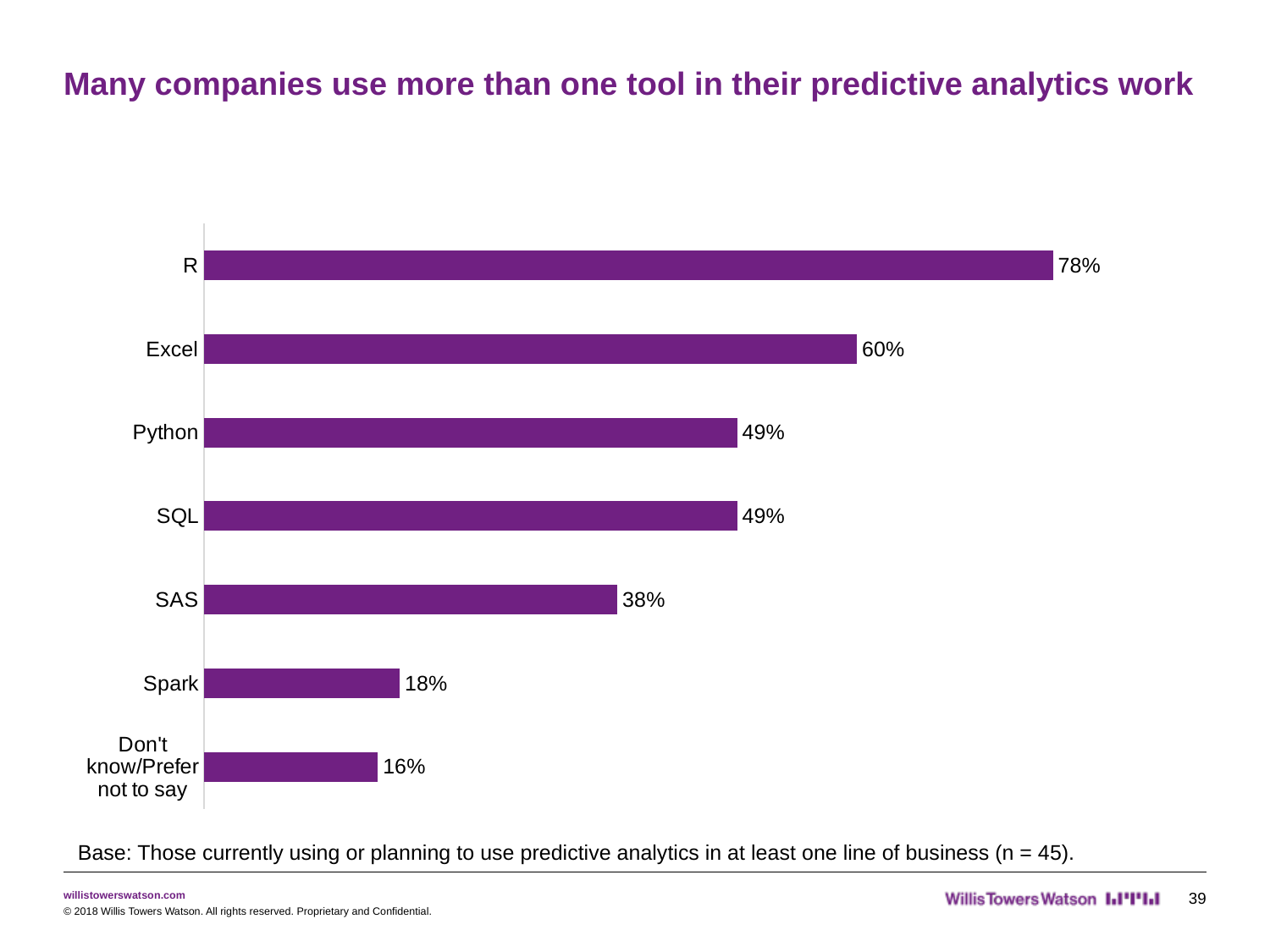
Which is larger, the value for SAS or the value for Spark? SAS What percentage is shown for SAS? 38% What percentage of companies use R? 78% What is the value shown for Excel? 60% What is the title of the slide? Many companies use more than one tool in their predictive analytics work How many categories are shown in the chart? 7 What is the value for Spark? 18% What kind of chart is shown on the slide? Bar chart What is the value for 'Don't know/Prefer not to say'? 16% Which category has the lowest percentage? Don't know/Prefer not to say Which tool has the highest percentage? R What is the difference between the percentages for R and Excel? 18%